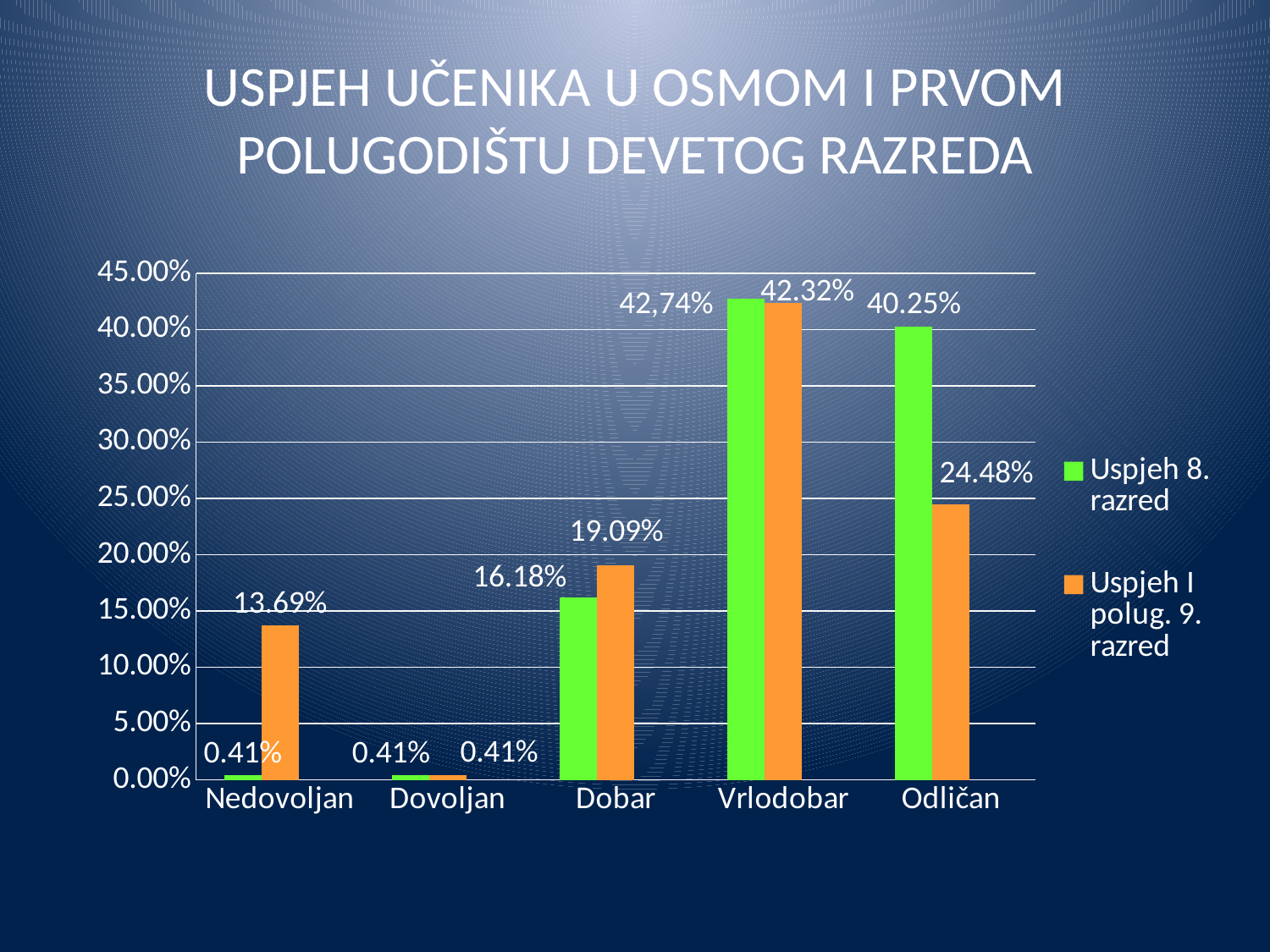
How many categories are shown on the x axis? 5 What is the value for Uspjeh I polug. 9. razred in the Nedovoljan category? 13.69% How many series does the legend list? 2 Which category has the lowest value for Uspjeh I polug. 9. razred? Dovoljan What is the difference between Uspjeh I polug. 9. razred and Uspjeh 8. razred in the Dobar category? 2.91% What is the value for Uspjeh 8. razred in the Vrlodobar category? 42,74% Which category has the highest value for Uspjeh I polug. 9. razred? Vrlodobar What is the value for Uspjeh I polug. 9. razred in the Dobar category? 19.09% In the Odličan category, which series has the larger value? Uspjeh 8. razred What kind of chart is shown on the slide? Bar chart What is the value for Uspjeh 8. razred in the Odličan category? 40.25% What is the difference between Uspjeh 8. razred and Uspjeh I polug. 9. razred in the Odličan category? 15.77%